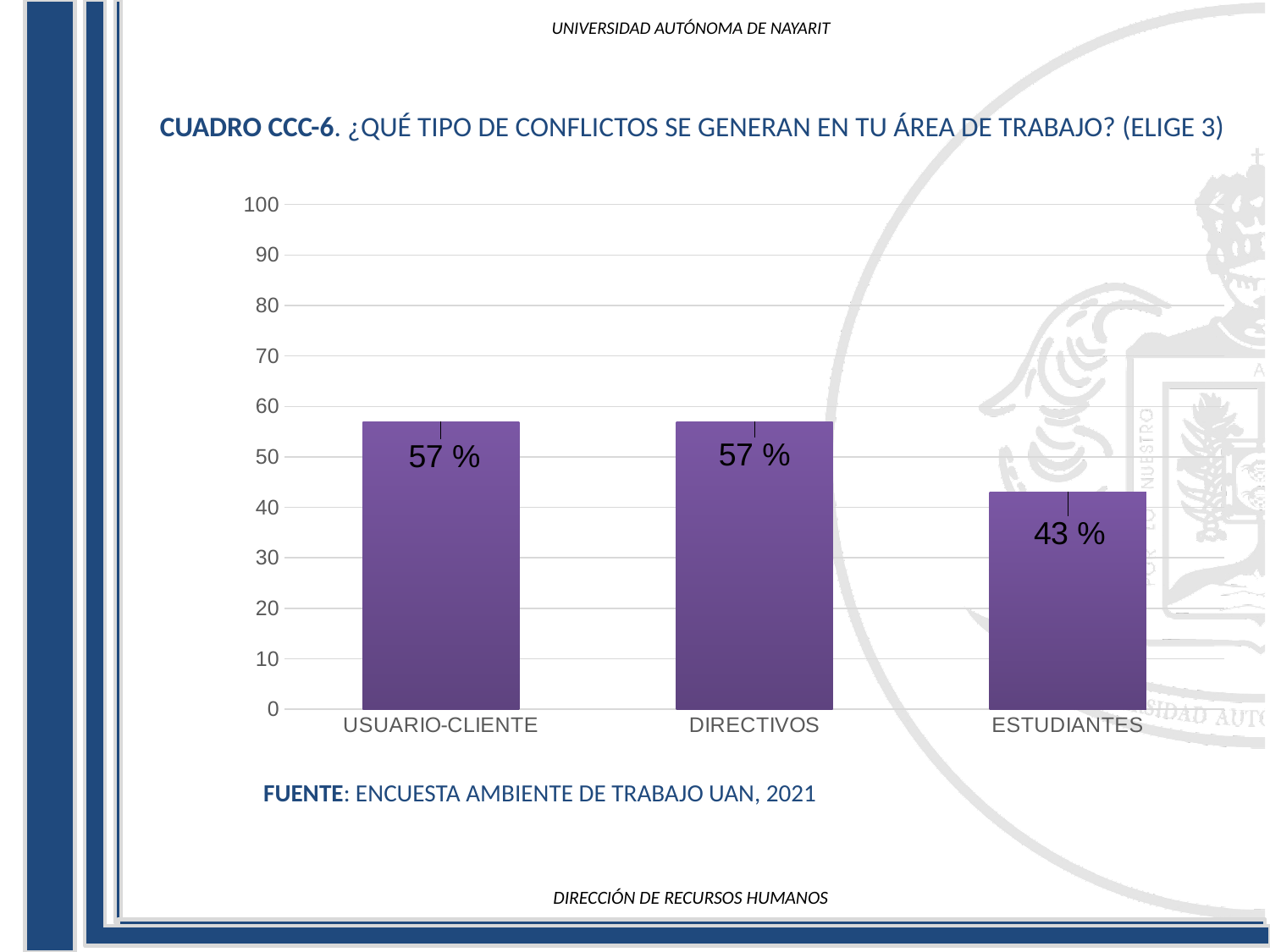
Is the value for ESTUDIANTES greater or less than 50? less Which category has the lowest value? ESTUDIANTES What source is cited below the chart? ENCUESTA AMBIENTE DE TRABAJO UAN, 2021 What is the value for ESTUDIANTES? 43 % What is the value for DIRECTIVOS? 57 % Which is larger, the value for USUARIO-CLIENTE or the value for ESTUDIANTES? USUARIO-CLIENTE What is the value for USUARIO-CLIENTE? 57 % Is the value for DIRECTIVOS greater or less than 50? greater What is the difference between the values for DIRECTIVOS and ESTUDIANTES? 14 % What is the maximum value shown on the y axis? 100 How many categories are shown on the x axis? 3 What kind of chart is shown on the slide? bar chart